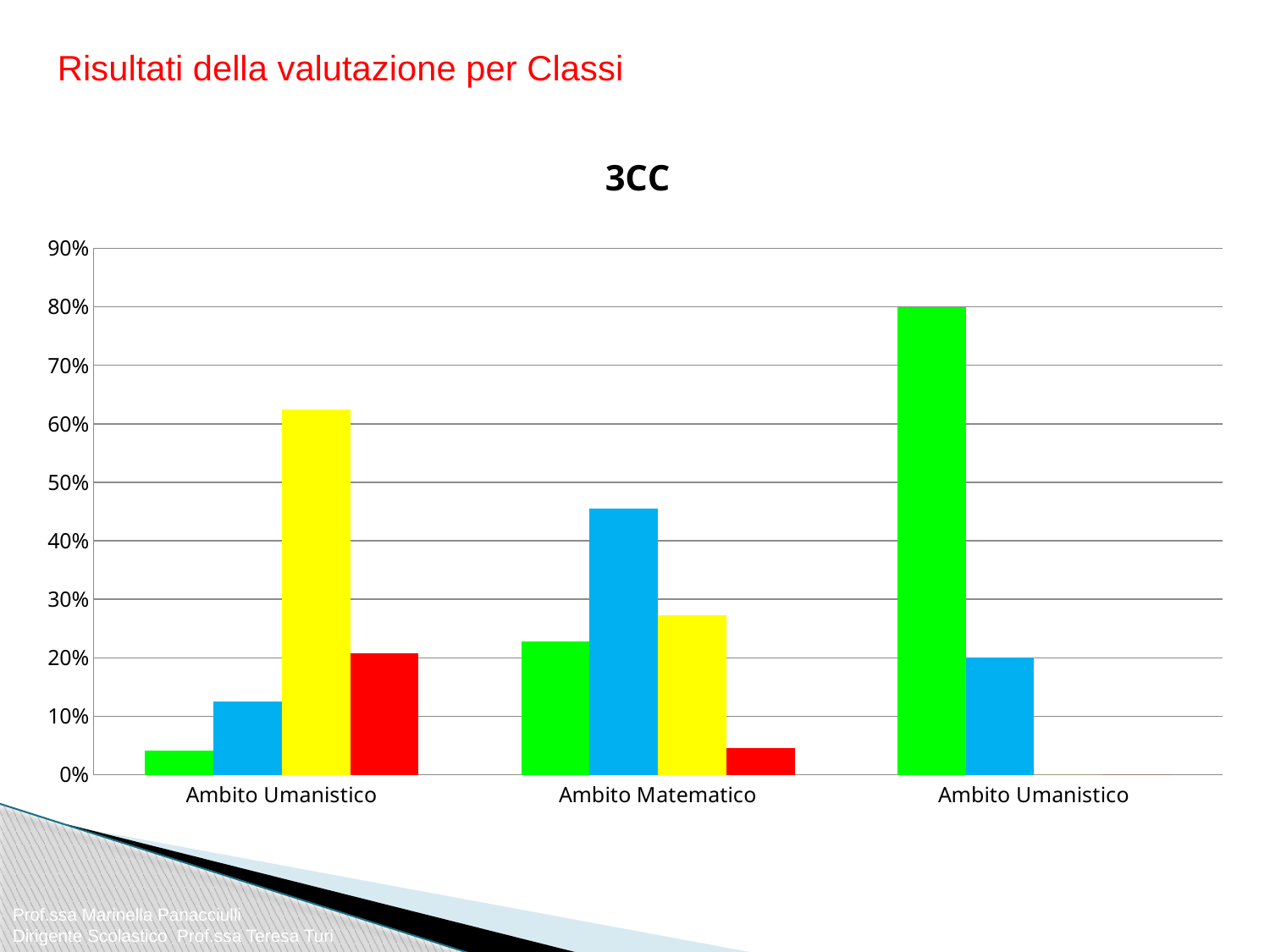
Is the value of the yellow bar in the leftmost Ambito Umanistico group greater or less than 50%? greater What is the value of the blue bar in the rightmost Ambito Umanistico group? 20% In the Ambito Matematico group, which is larger, the blue bar or the yellow bar? the blue bar How many categories are shown on the x axis of the chart? 3 Is the value of the blue bar for Ambito Matematico greater or less than 40%? greater In the Ambito Matematico group, which coloured bar is the lowest? the red bar What is the difference between the green bar and the blue bar in the rightmost Ambito Umanistico group? 60% What is the value of the green bar in the rightmost Ambito Umanistico group? 80% What is the title of the chart? 3CC Is the value of the yellow bar for Ambito Matematico greater or less than 30%? less What kind of chart is shown on the slide? bar chart Which bar is the tallest in the whole chart? the green bar in the rightmost Ambito Umanistico group